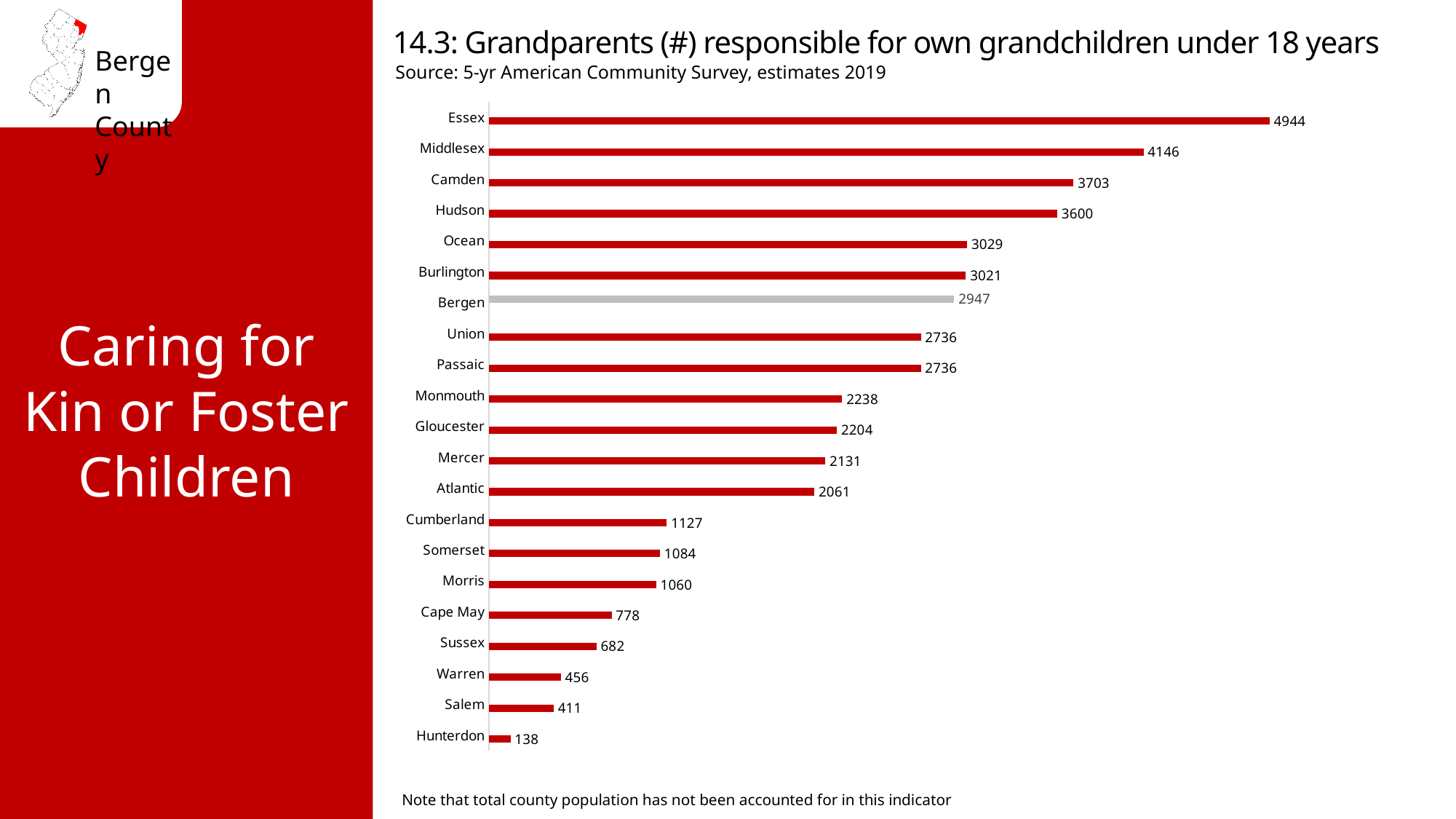
What is the difference between the values for Essex and Middlesex? 798 What is the value for Hudson? 3600 Which county has the highest value? Essex What kind of chart is this? Bar chart Which is larger, the value for Morris or the value for Sussex? Morris Which is larger, the value for Camden or the value for Ocean? Camden How many counties are shown in the chart? 21 Which county has the lowest value? Hunterdon What is the value for Bergen? 2947 What is the value for Cape May? 778 What is the difference between the values for Bergen and Burlington? 74 Which county's bar is shown in grey instead of red? Bergen